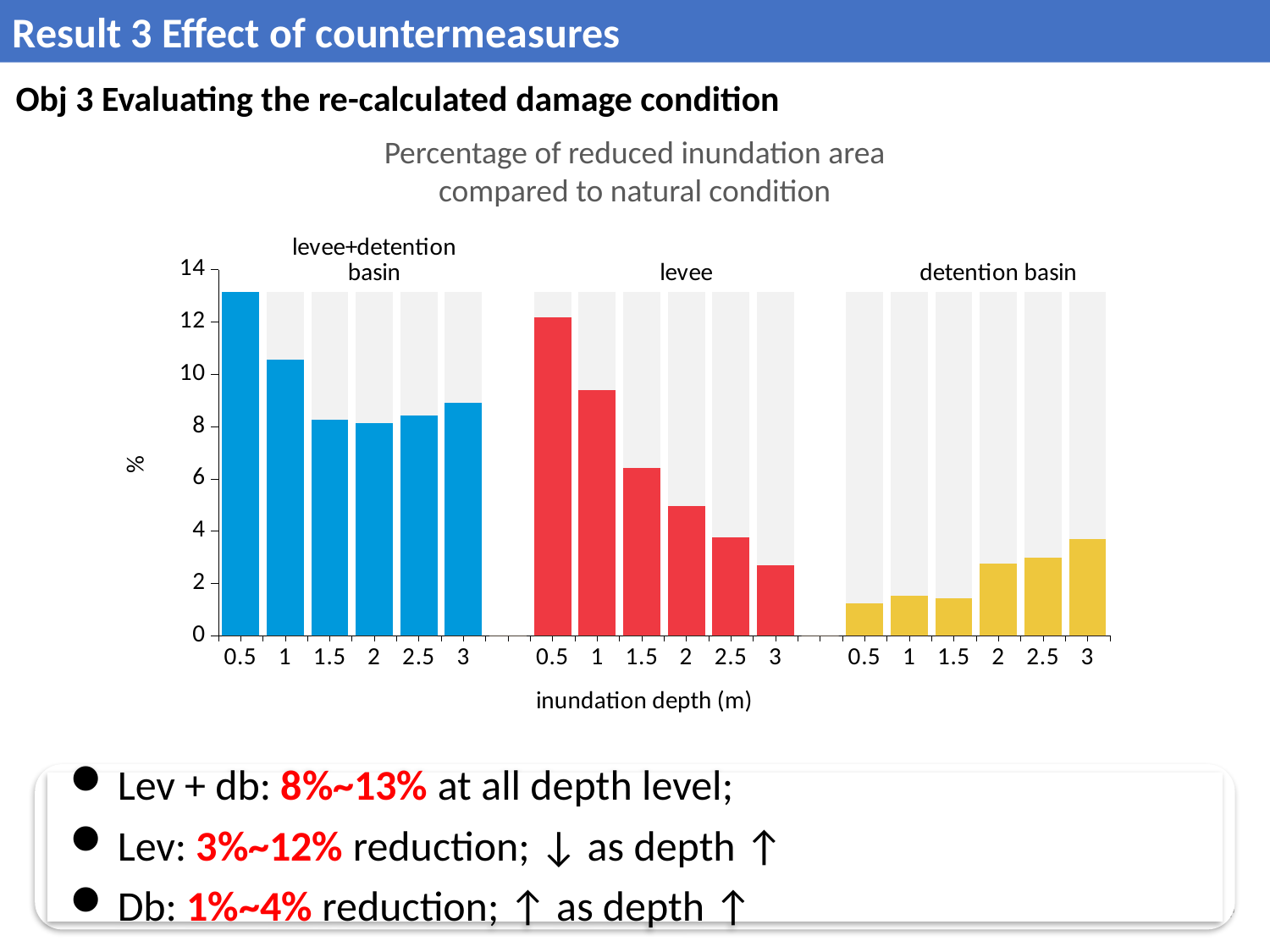
Which inundation depth has the highest bar in the levee+detention basin group? 0.5 How many bars are in the levee group? 6 In the levee group, do the values rise or fall as inundation depth increases? fall Is the value for the levee group at depth 3 greater or less than 4? less How many countermeasure groups are plotted in the chart? 3 What kind of chart is shown on the slide? bar chart At inundation depth 1, which is larger: the levee+detention basin value or the levee value? levee+detention basin Is the value for the levee+detention basin group at depth 0.5 greater or less than 12? greater Which inundation depth has the lowest bar in the levee group? 3 What is the label of the x axis of the chart? inundation depth (m) What is the title of the chart? Percentage of reduced inundation area compared to natural condition In the detention basin group, do the values generally rise or fall as inundation depth increases? rise